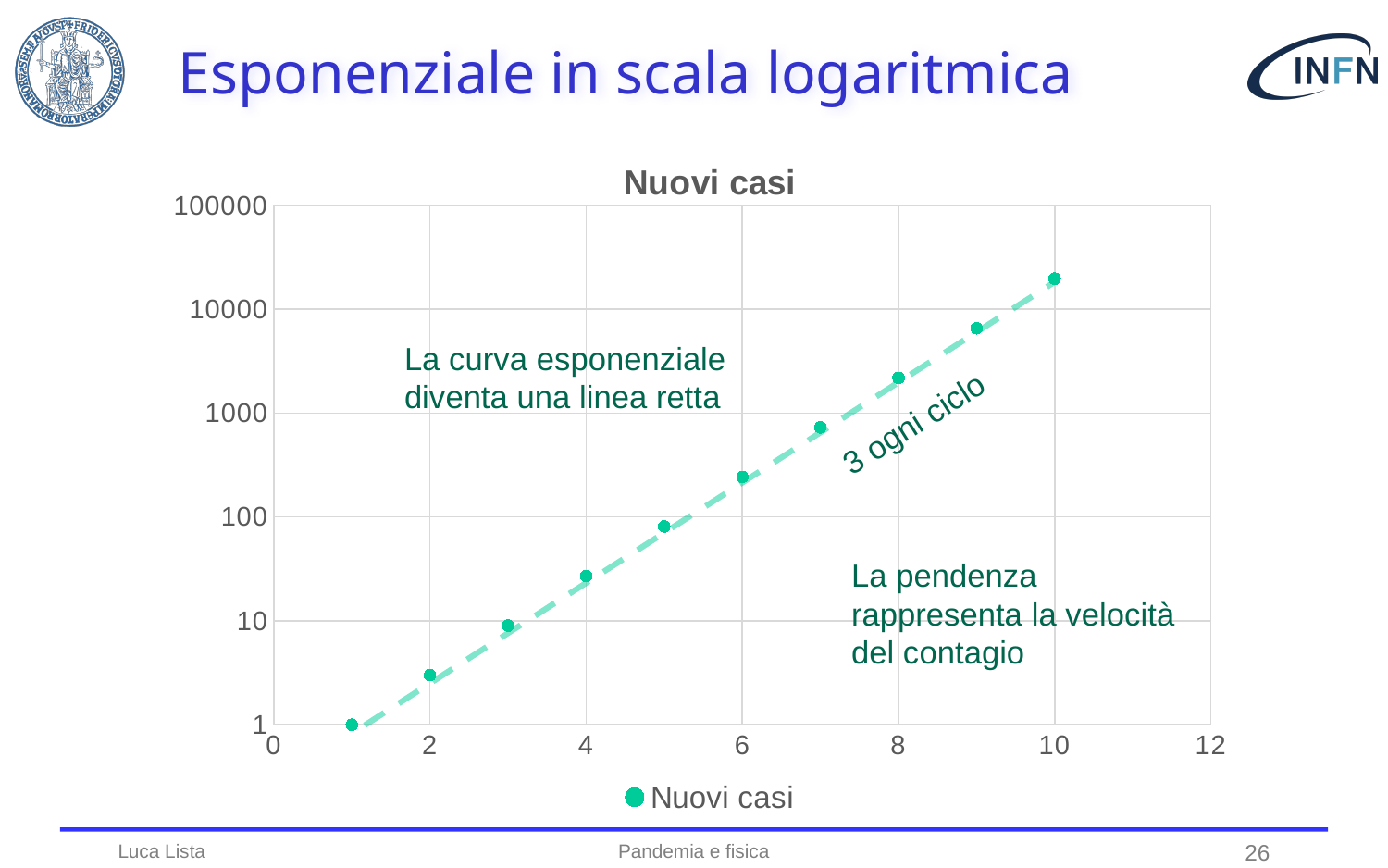
Do the values rise or fall as x increases from 1 to 10? rise Is the value at x = 8 greater or less than 1000? greater What kind of chart is shown on the slide? scatter chart Which is larger, the value at x = 7 or the value at x = 5? x = 7 At which x value is the plotted value highest? 10 How many data points are plotted in the chart? 10 What is the plotted value at x = 1? 1 What is the title of the chart? Nuovi casi Is the value at x = 4 greater or less than 100? less Is the value at x = 10 greater or less than 10000? greater How many series does the legend list? 1 At which x value is the plotted value lowest? 1